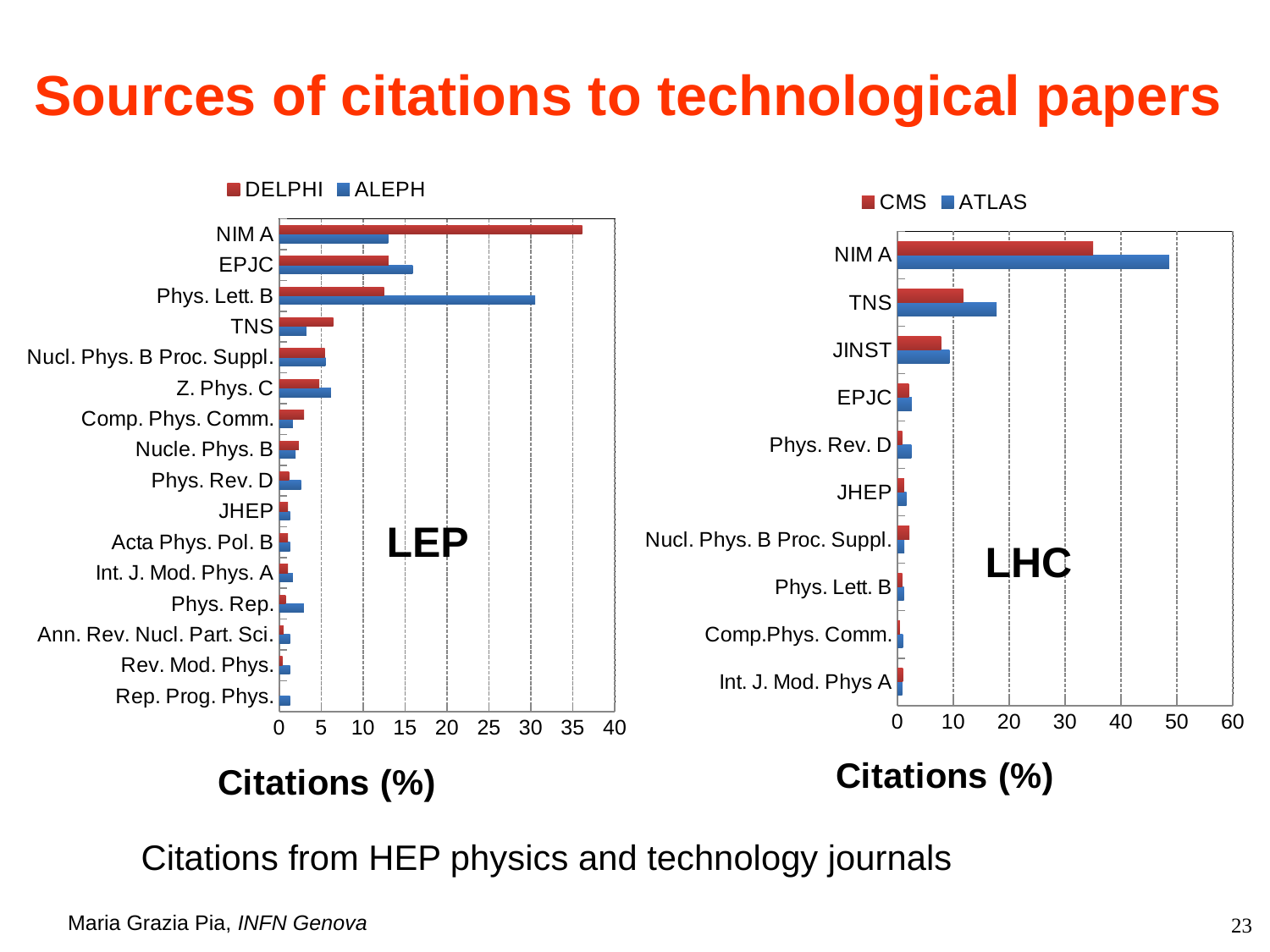
In the LHC chart, which is larger for TNS, CMS or ATLAS? ATLAS What kind of chart is the LEP chart on the left? bar chart How many series does the legend of the LHC chart list? 2 In the LEP chart, is the DELPHI value for NIM A greater or less than 30? greater How many journal categories are shown on the LHC chart? 10 In the LEP chart, which is larger for Phys. Lett. B, DELPHI or ALEPH? ALEPH In the LHC chart, is the ATLAS value for NIM A greater or less than 40? greater In the LHC chart, is the CMS value for JINST greater or less than 10? less In the LEP chart, which journal has the highest DELPHI value? NIM A In the LEP chart, which journal has the highest ALEPH value? Phys. Lett. B In the LHC chart, which journal has the highest ATLAS value? NIM A How many journal categories are shown on the LEP chart? 16